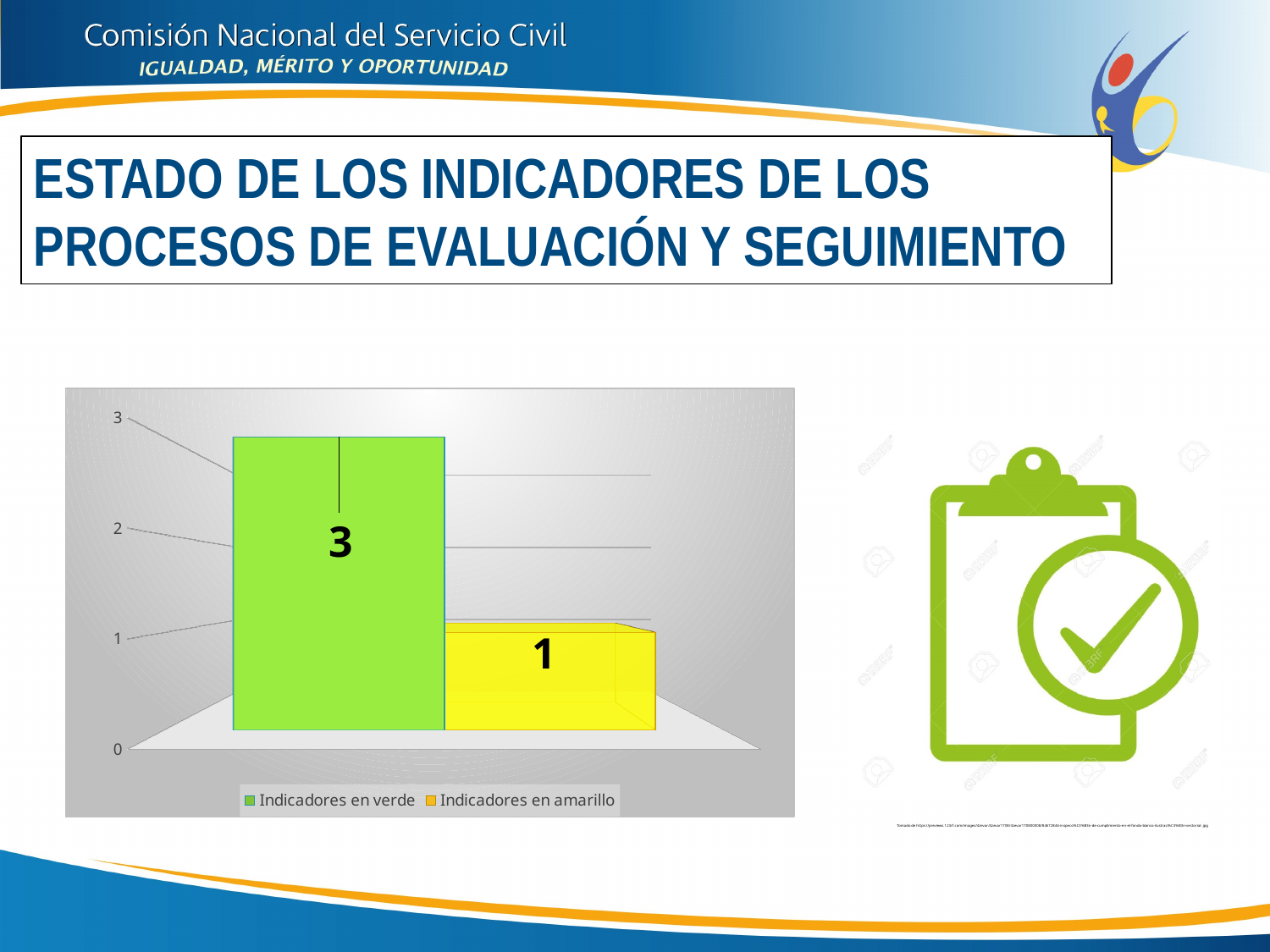
Which series has the lowest value? Indicadores en amarillo What kind of chart is shown on the slide? bar chart Which is larger, the value for Indicadores en verde or Indicadores en amarillo? Indicadores en verde Is the value for Indicadores en verde greater or less than 2? greater What colour is the bar for Indicadores en amarillo? yellow What is the total of the two plotted values? 4 How many series does the legend list? 2 Is the value for Indicadores en amarillo greater or less than 2? less What is the value for Indicadores en amarillo? 1 What is the difference between the values for Indicadores en verde and Indicadores en amarillo? 2 Which series has the highest value? Indicadores en verde What is the value for Indicadores en verde? 3